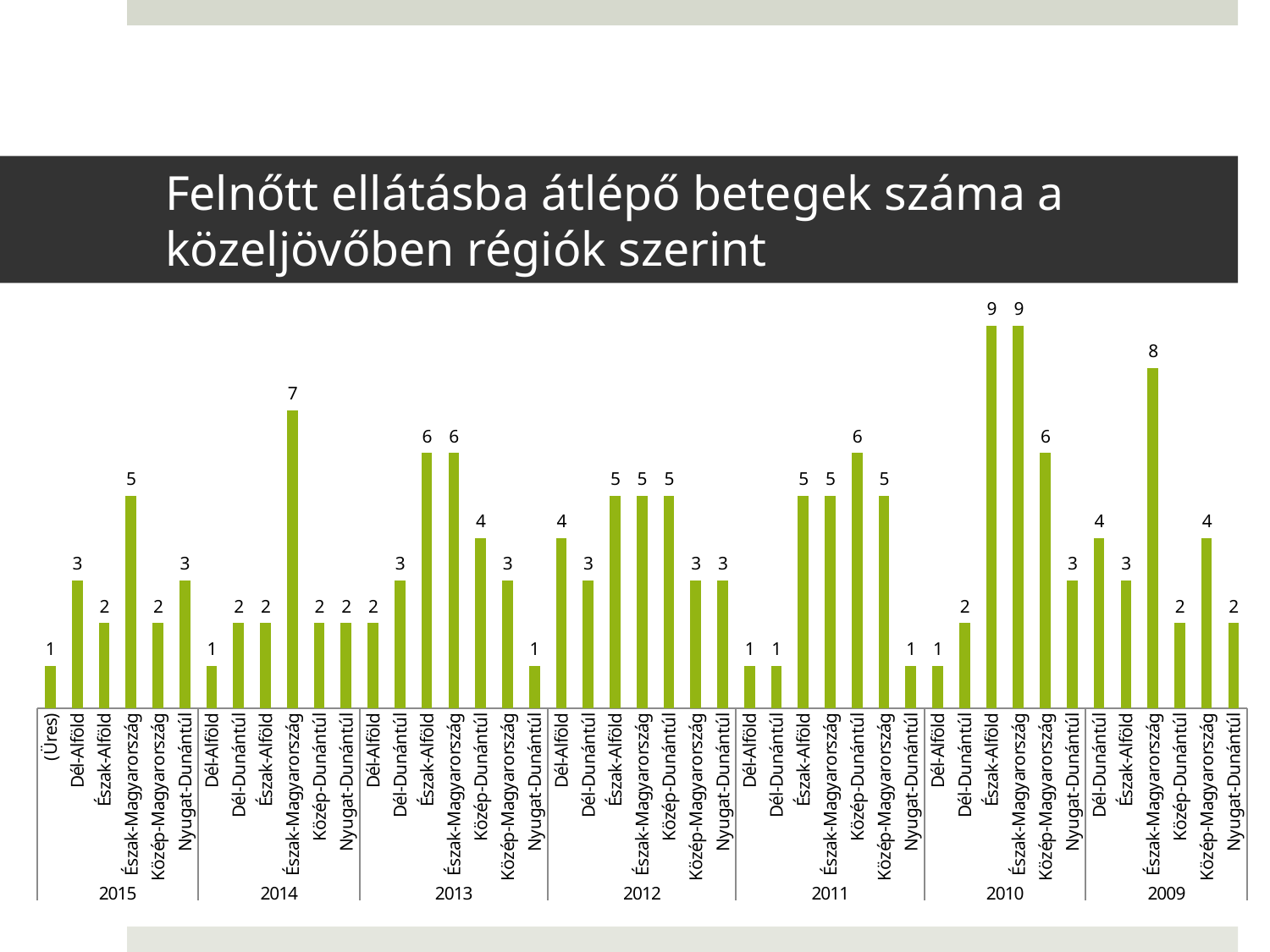
Which year group contains the highest bars in the chart? 2010 What is the value for Észak-Magyarország in 2014? 7 What type of chart is shown on the slide? Bar chart What is the title of the chart on the slide? Felnőtt ellátásba átlépő betegek száma a közeljövőben régiók szerint How many year groups are shown on the x axis? 7 What is the value for Nyugat-Dunántúl in 2013? 1 Which is larger: Dél-Alföld in 2012 or Dél-Alföld in 2011? Dél-Alföld in 2012 How many bars are plotted in the 2013 group? 7 What is the highest value shown in the chart? 9 What is the value for Közép-Dunántúl in 2011? 6 What is the difference between Észak-Alföld in 2010 and Észak-Alföld in 2009? 6 What is the value for Észak-Magyarország in 2009? 8